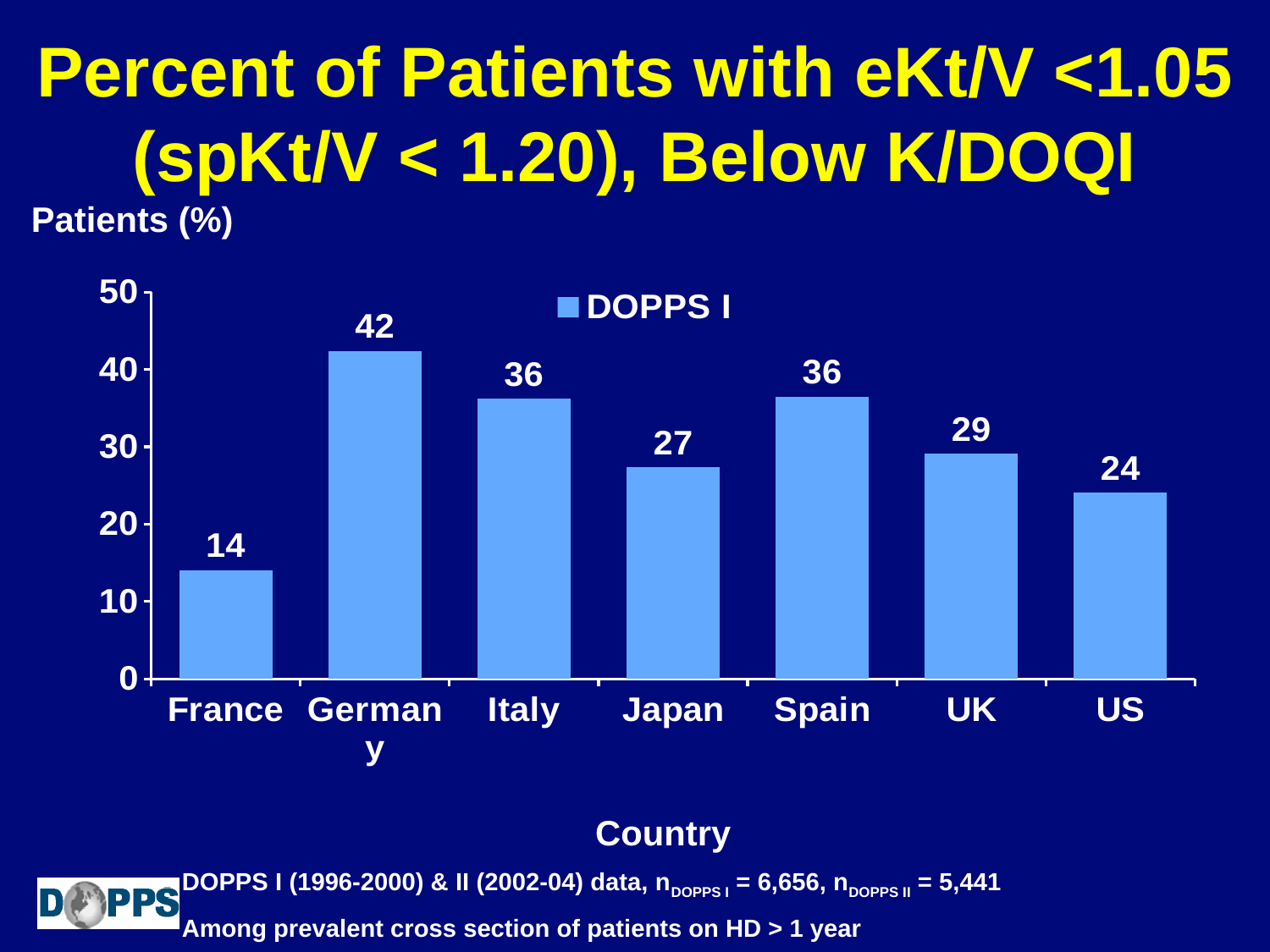
What is the value for France? 14 Which country has the highest value? Germany What is the difference between the values for UK and US? 5 What is the difference between the values for Germany and France? 28 What is the value for the US? 24 Which is larger, the value for Japan or the value for UK? UK What kind of chart is shown? Bar chart How many countries are shown on the x axis? 7 Which country has the lowest value? France What is the value for Germany? 42 What is the series name shown in the legend? DOPPS I How many series does the legend list? 1